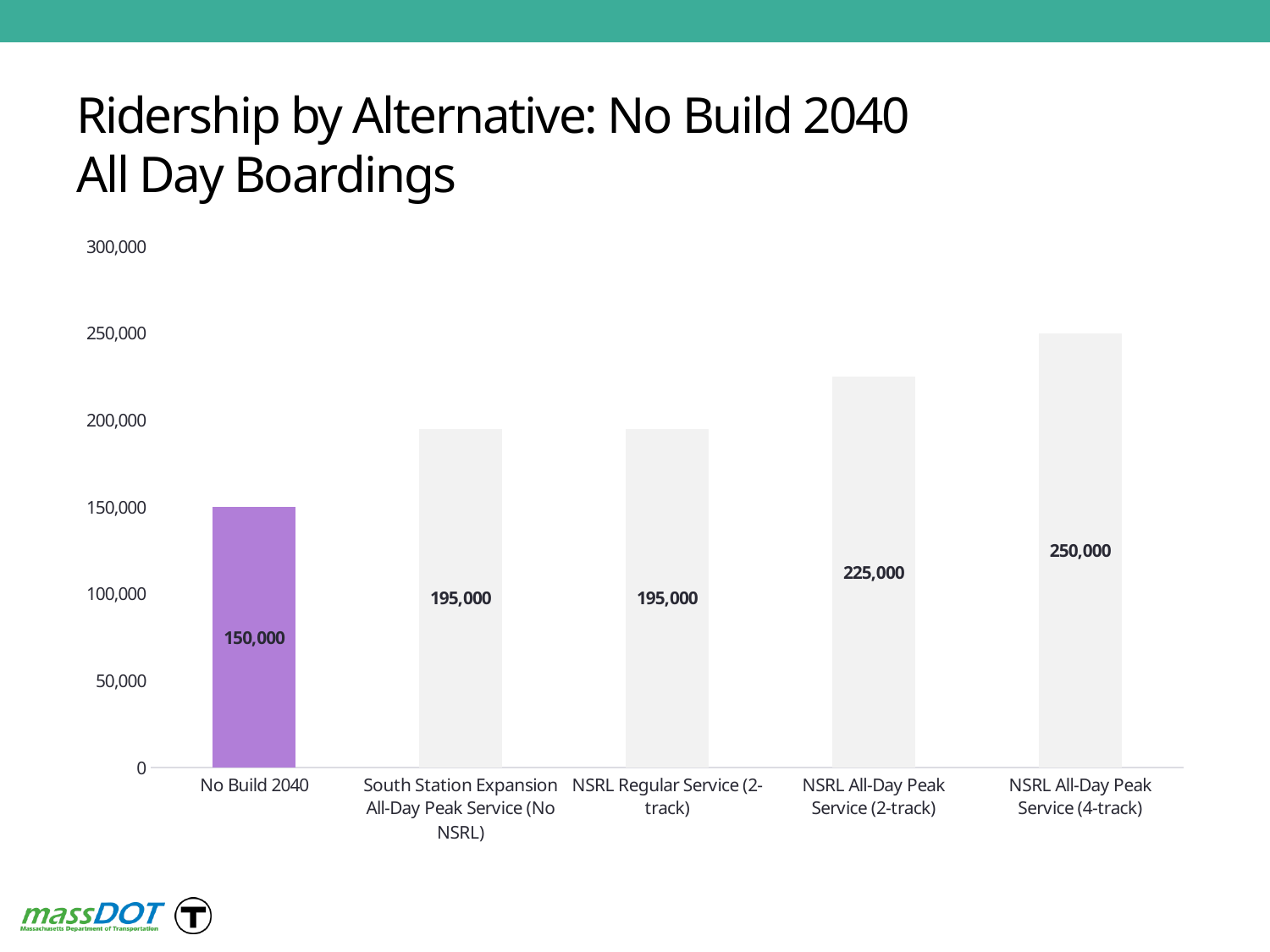
Which is larger, NSRL All-Day Peak Service (2-track) or South Station Expansion All-Day Peak Service (No NSRL)? NSRL All-Day Peak Service (2-track) What kind of chart is shown on the slide? bar chart What is the difference between NSRL All-Day Peak Service (2-track) and NSRL Regular Service (2-track)? 30,000 What is the value for NSRL Regular Service (2-track)? 195,000 Which alternative has the lowest all day boardings? No Build 2040 What is the difference between NSRL All-Day Peak Service (4-track) and No Build 2040? 100,000 Is the value for NSRL All-Day Peak Service (4-track) greater or less than 200,000? greater What is the value for No Build 2040? 150,000 What is the value for NSRL All-Day Peak Service (2-track)? 225,000 Which bar is highlighted in purple? No Build 2040 How many alternatives are shown in the chart? 5 Which alternative has the highest all day boardings? NSRL All-Day Peak Service (4-track)